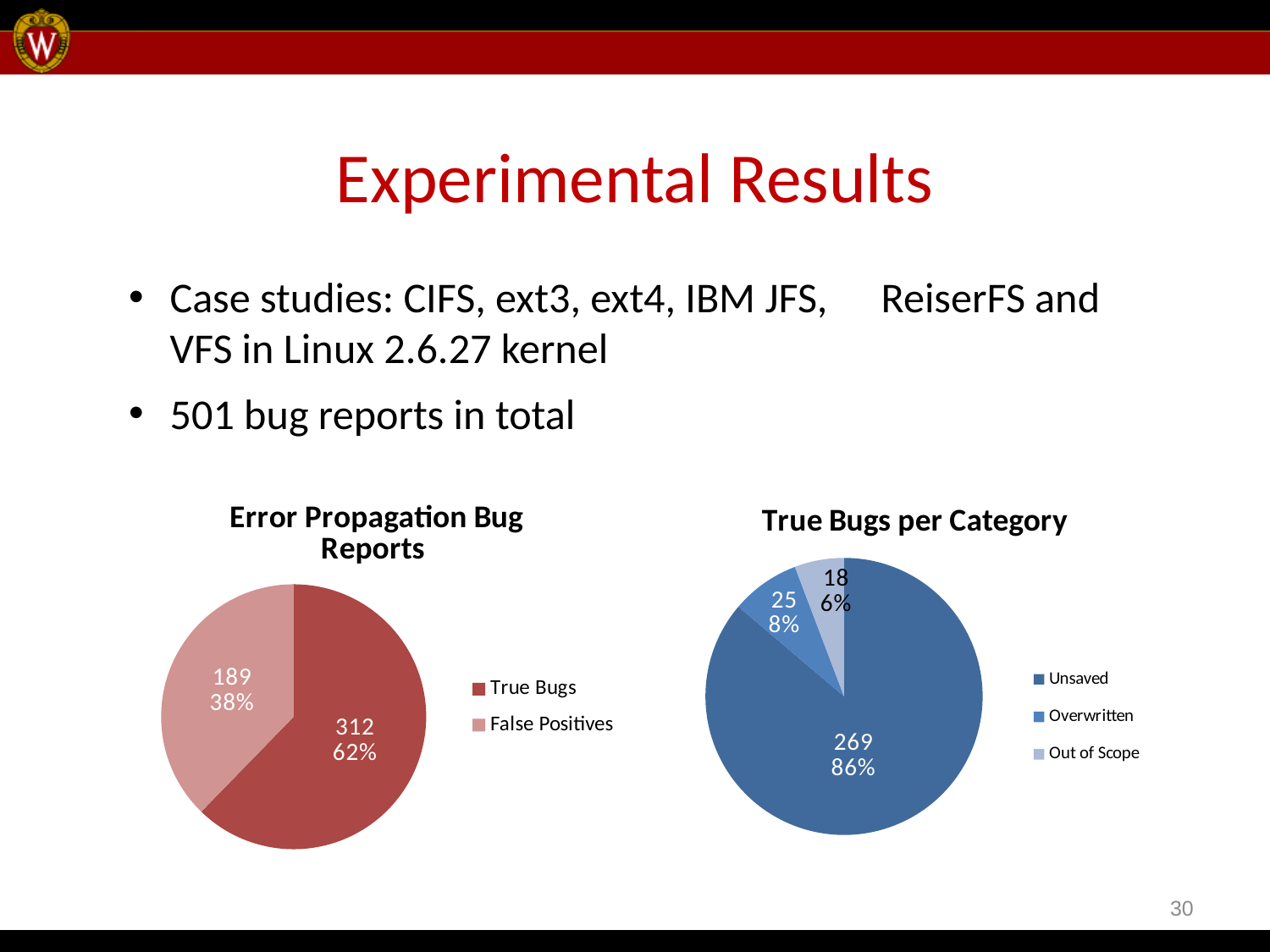
In the 'Error Propagation Bug Reports' chart, what is the total of the two slices? 501 How many categories does the 'True Bugs per Category' chart show? 3 In the 'Error Propagation Bug Reports' chart, what is the value for True Bugs? 312 What kind of chart is 'True Bugs per Category'? Pie chart In the 'True Bugs per Category' chart, which category is the largest? Unsaved In the 'True Bugs per Category' chart, what is the difference between Overwritten and Out of Scope? 7 In the 'True Bugs per Category' chart, which category is the smallest? Out of Scope In the 'True Bugs per Category' chart, what share of the pie is Unsaved? 86% In the 'Error Propagation Bug Reports' chart, what is the difference between True Bugs and False Positives? 123 In the 'True Bugs per Category' chart, what is the value for Overwritten? 25 In the 'Error Propagation Bug Reports' chart, what share of the pie is False Positives? 38% In the 'Error Propagation Bug Reports' chart, which slice is larger, True Bugs or False Positives? True Bugs